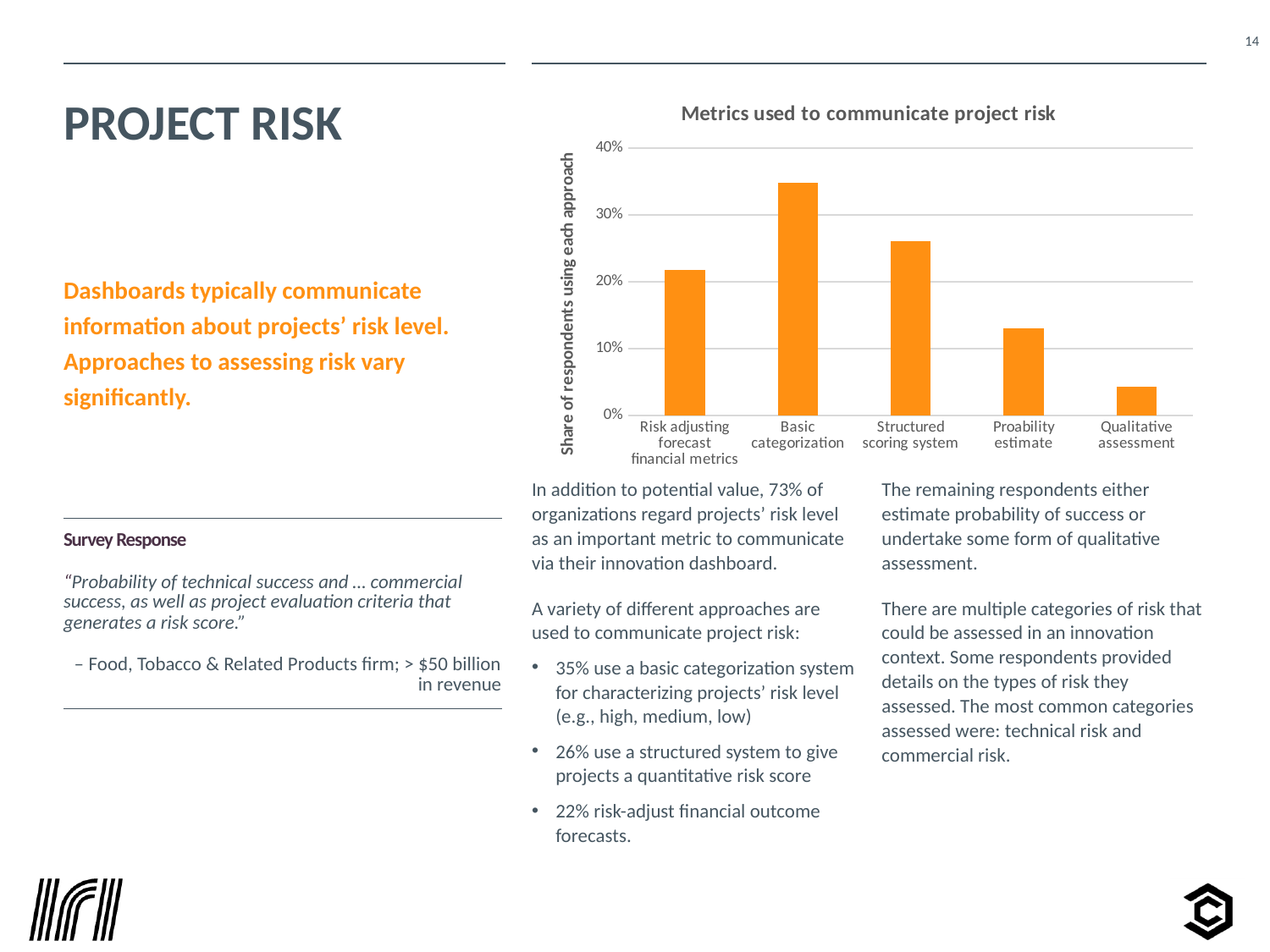
How many categories are shown on the x axis of the chart? 5 Is the value for Qualitative assessment greater or less than 10%? less What kind of chart is shown on the slide? bar chart Which is larger: the value for Proability estimate or the value for Qualitative assessment? Proability estimate Which category has the highest share of respondents? Basic categorization What is the label of the vertical axis of the chart? Share of respondents using each approach Is the value for Proability estimate greater or less than 10%? greater Which category has the lowest share of respondents? Qualitative assessment Is the value for Basic categorization greater or less than 30%? greater Which is larger: the value for Structured scoring system or the value for Risk adjusting forecast financial metrics? Structured scoring system What is the title of the chart? Metrics used to communicate project risk